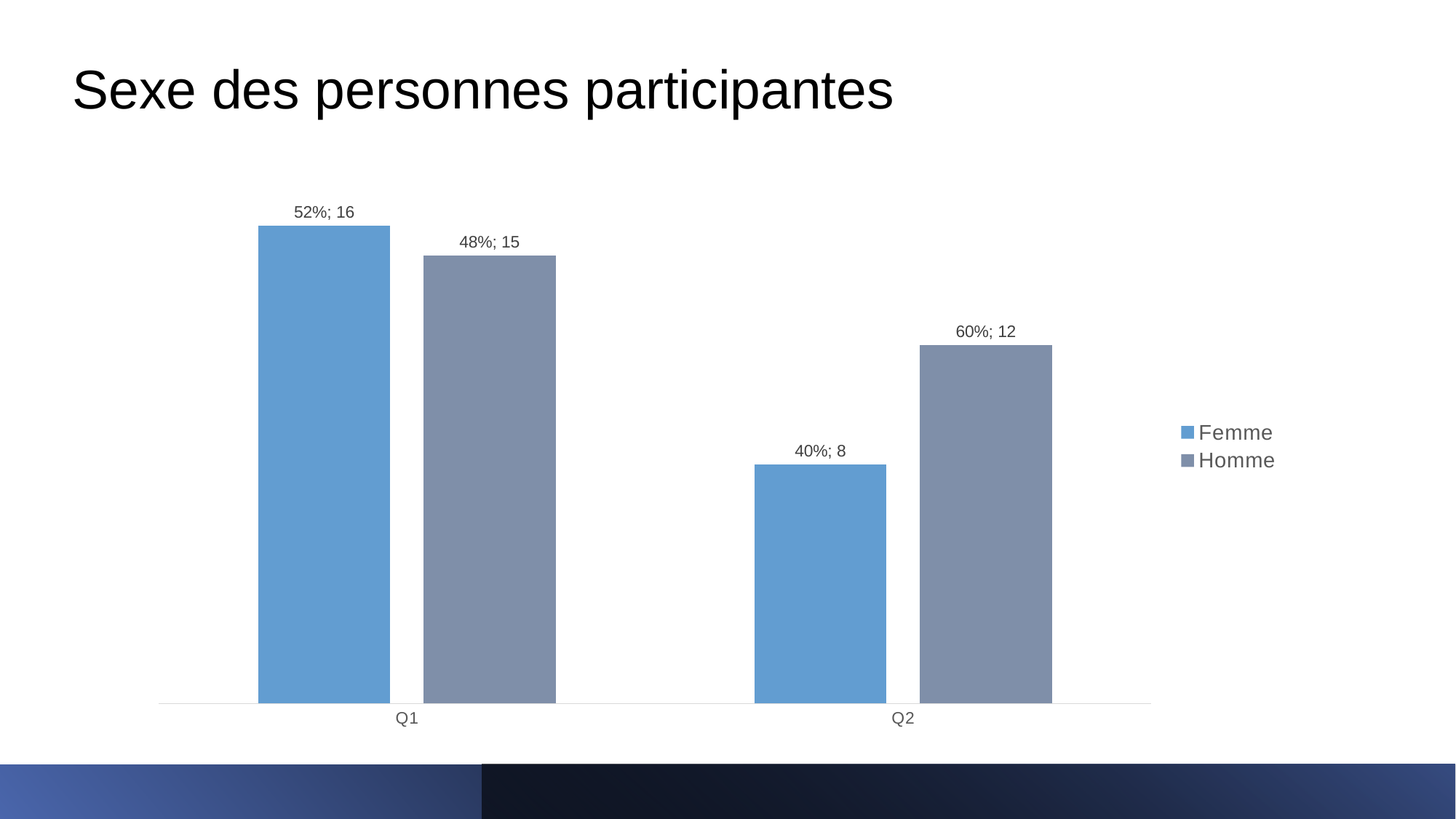
How many Femme participants are shown for Q2? 8 Which series has the highest count in Q1? Femme Which bar has the lowest count on the chart? Femme in Q2 In Q2, which is larger, Femme or Homme? Homme What is the data label for Femme in Q1? 52%; 16 What percentage is shown for Homme in Q1? 48% How many series does the legend list? 2 What kind of chart is shown on the slide? Bar chart What is the difference in count between Homme and Femme in Q2? 4 How many categories are shown on the x axis? 2 What is the data label for Homme in Q2? 60%; 12 What is the difference in count between Femme and Homme in Q1? 1